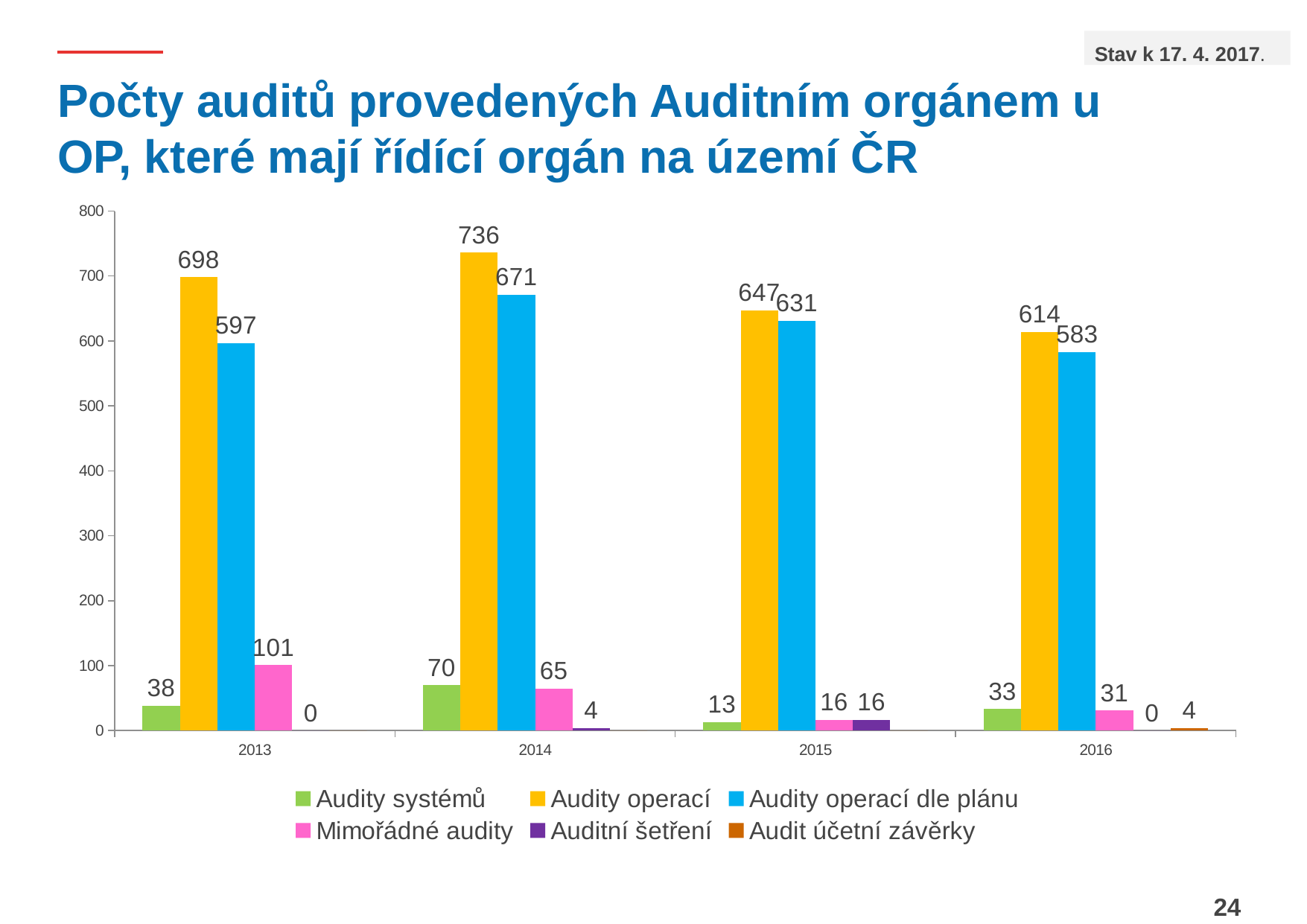
What kind of chart is shown on the slide? bar chart How many series does the legend list? 6 What is the value for Audity operací dle plánu in 2016? 583 In 2015, which is larger: Audity operací or Audity operací dle plánu? Audity operací In which year is the value for Audity operací the highest? 2014 What is the value for Mimořádné audity in 2013? 101 What is the value for Audity operací in 2014? 736 Which series is shown in yellow in the legend? Audity operací Do the values for Audity operací rise or fall from 2014 to 2016? fall What is the difference between Audity operací and Audity operací dle plánu in 2013? 101 In which year is the value for Audity systémů the lowest? 2015 How many years are shown on the x axis? 4